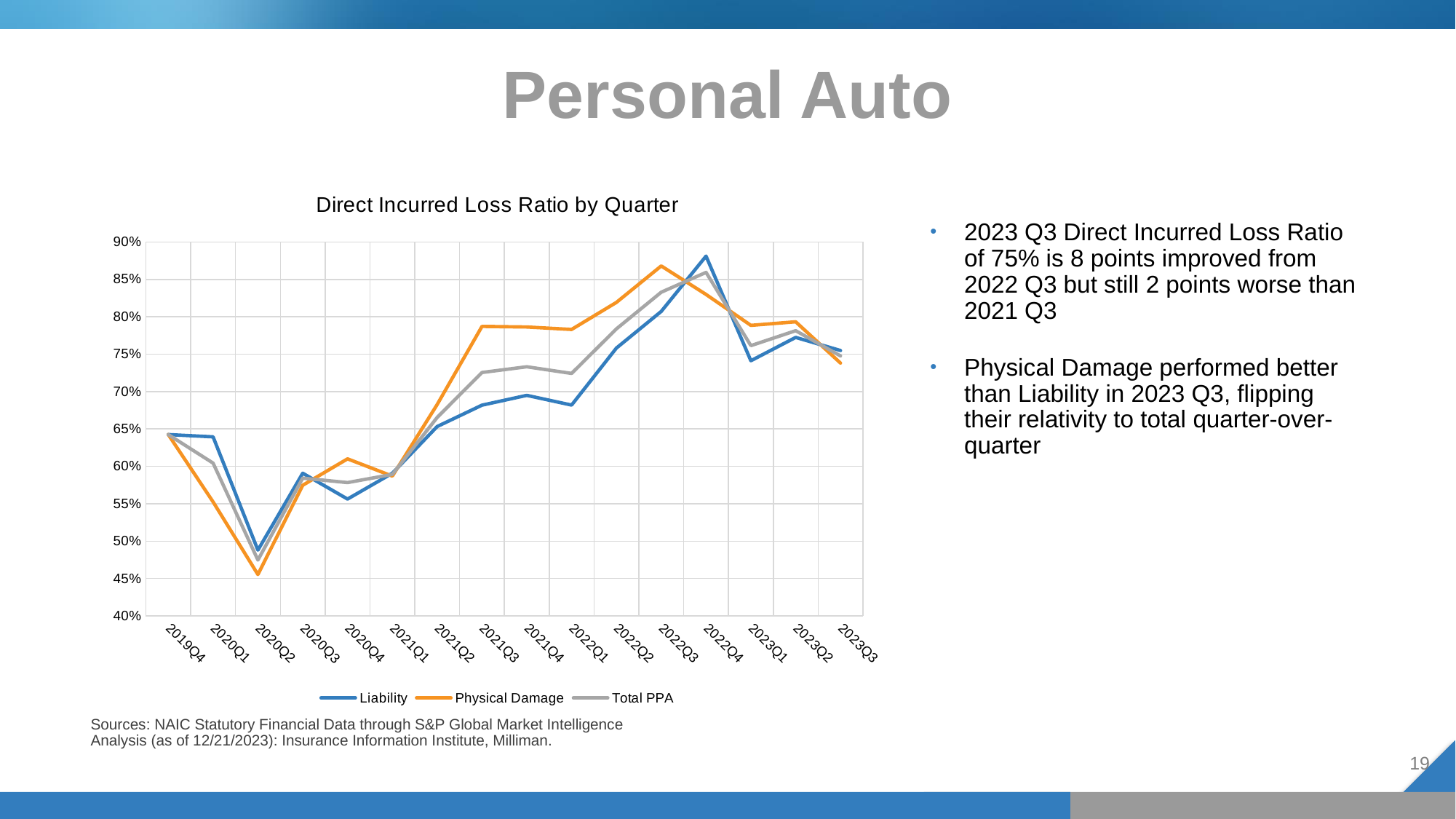
How many series does the legend of the chart list? 3 Which series has the higher value in 2021Q3, Liability or Physical Damage? Physical Damage What is the title of the chart? Direct Incurred Loss Ratio by Quarter Is the Physical Damage value for 2020Q2 greater or less than 50%? less Is the Liability value for 2022Q4 greater or less than 85%? greater Does the Physical Damage line rise or fall from 2022Q3 to 2023Q3? fall In which quarter does the Physical Damage line reach its lowest value? 2020Q2 Which colour is used for the Physical Damage line in the chart? orange How many quarters are plotted along the x axis of the chart? 16 What kind of chart is shown on the slide? line chart In which quarter does the Physical Damage line reach its highest value? 2022Q3 In which quarter does the Liability line reach its highest value? 2022Q4